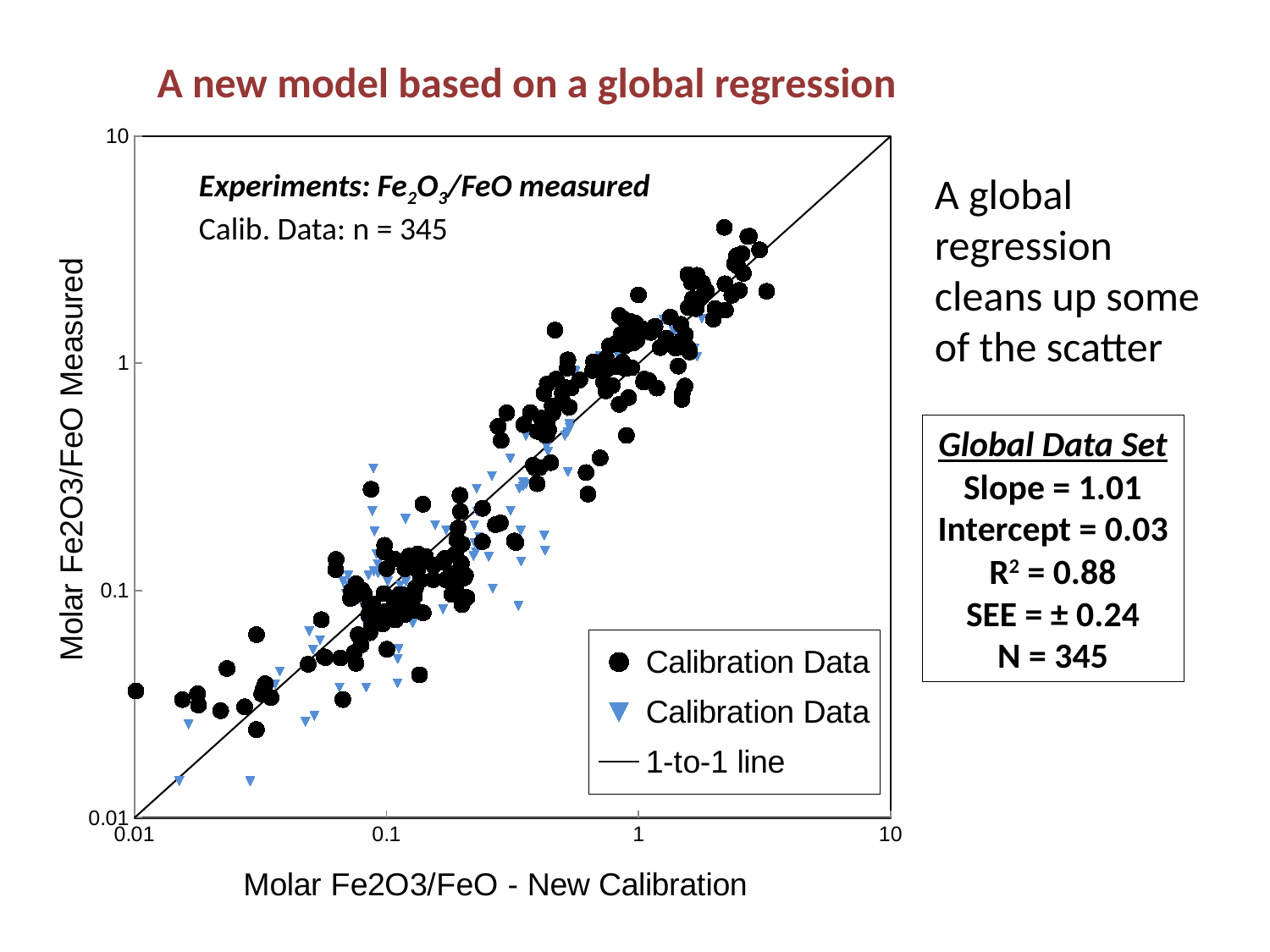
Is the highest measured value among the black circle Calibration Data points greater or less than 1? greater How many entries does the chart legend list? 3 Is the lowest measured value among the black circle Calibration Data points greater or less than 0.1? less Do the measured Fe2O3/FeO values generally rise or fall as the new-calibration values increase along the x axis? rise What is the label of the x axis of the chart? Molar Fe2O3/FeO - New Calibration According to the annotation on the chart, how many calibration data points are there (n)? 345 What kind of chart is shown on the slide? scatter plot What is the name of the line series listed in the chart legend? 1-to-1 line